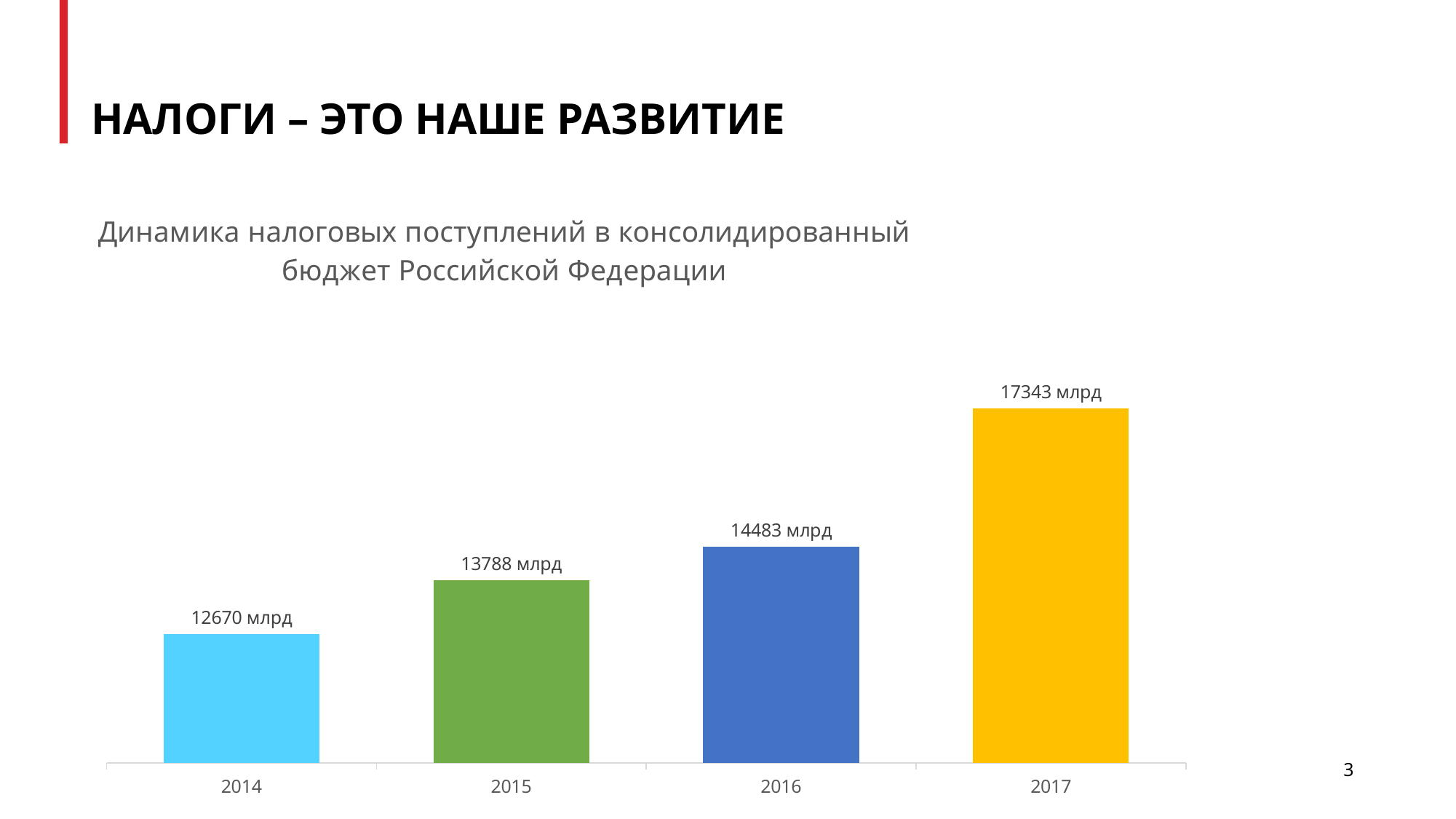
What kind of chart is shown on the slide? Bar chart What is the value for 2014? 12670 млрд What is the value for 2015? 13788 млрд How many years are shown on the chart? 4 Do the values rise or fall from 2014 to 2017? Rise Which is larger, the value for 2016 or the value for 2015? 2016 What is the difference between the values for 2015 and 2014? 1118 млрд What is the value for 2017? 17343 млрд What is the difference between the values for 2017 and 2016? 2860 млрд Which year has the highest value? 2017 What is the value for 2016? 14483 млрд Which year has the lowest value? 2014